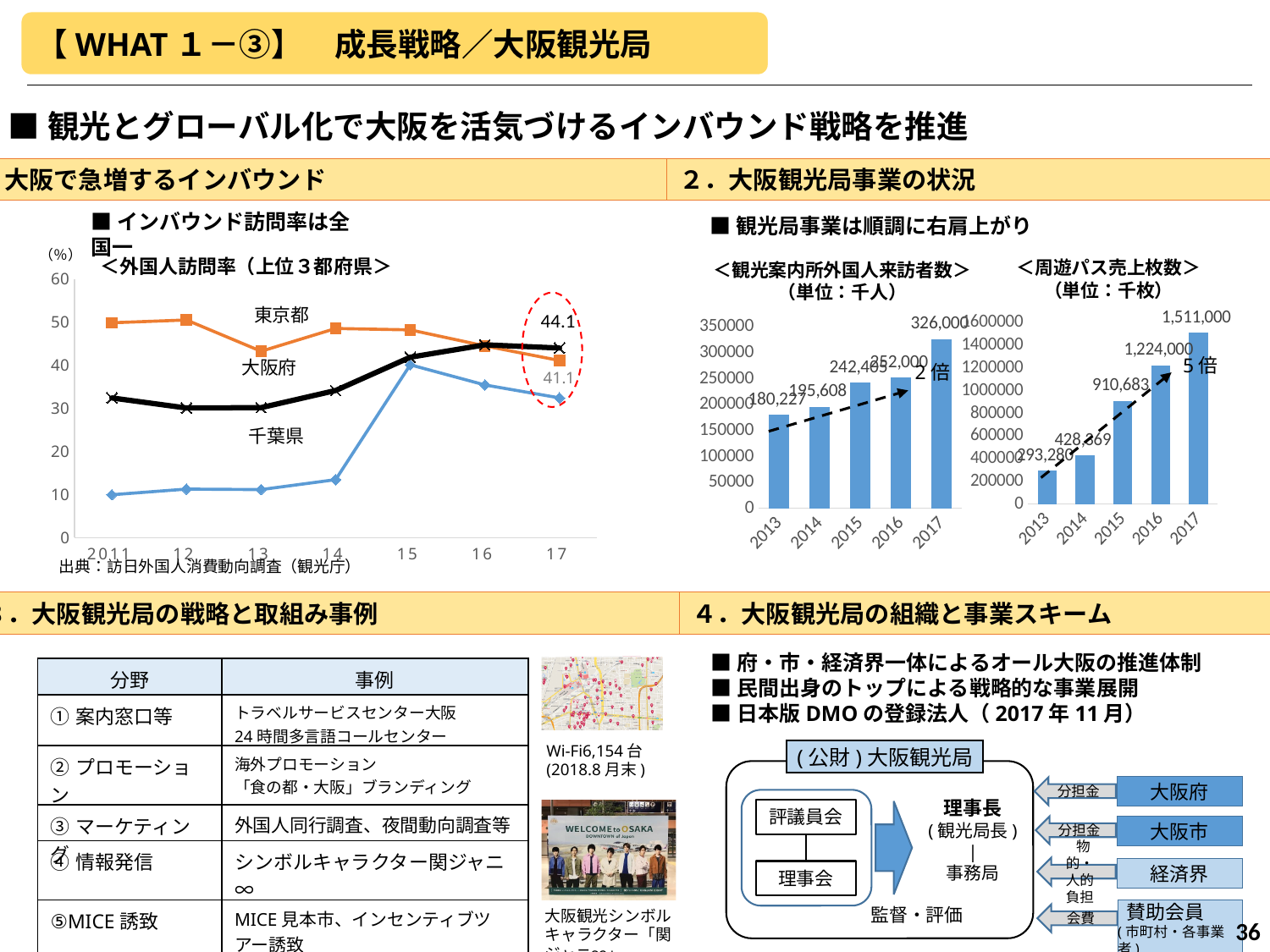
In the 観光案内所外国人来訪者数 chart, what is the value for 2017? 326,000 In the 観光案内所外国人来訪者数 chart, what is the value for 2013? 180,227 In the 周遊パス売上枚数 chart, what is the value for 2017? 1,511,000 In the 観光案内所外国人来訪者数 chart, what is the difference between the 2017 and 2013 values? 145,773 In the 外国人訪問率（上位３都府県） chart, what is the value for 東京都 in 2017? 41.1 How many series are plotted in the 外国人訪問率（上位３都府県） line chart? 3 In the 外国人訪問率（上位３都府県） chart, is the value for 千葉県 in 2011 greater or less than 20? less In the 周遊パス売上枚数 chart, do the values rise or fall from 2013 to 2017? rise In the 周遊パス売上枚数 chart, which year has the highest value? 2017 What kind of chart is the 外国人訪問率（上位３都府県） chart? line chart In the 外国人訪問率（上位３都府県） chart, what is the value for 大阪府 in 2017? 44.1 In the 外国人訪問率（上位３都府県） chart, which is larger in 2017: 大阪府 or 東京都? 大阪府